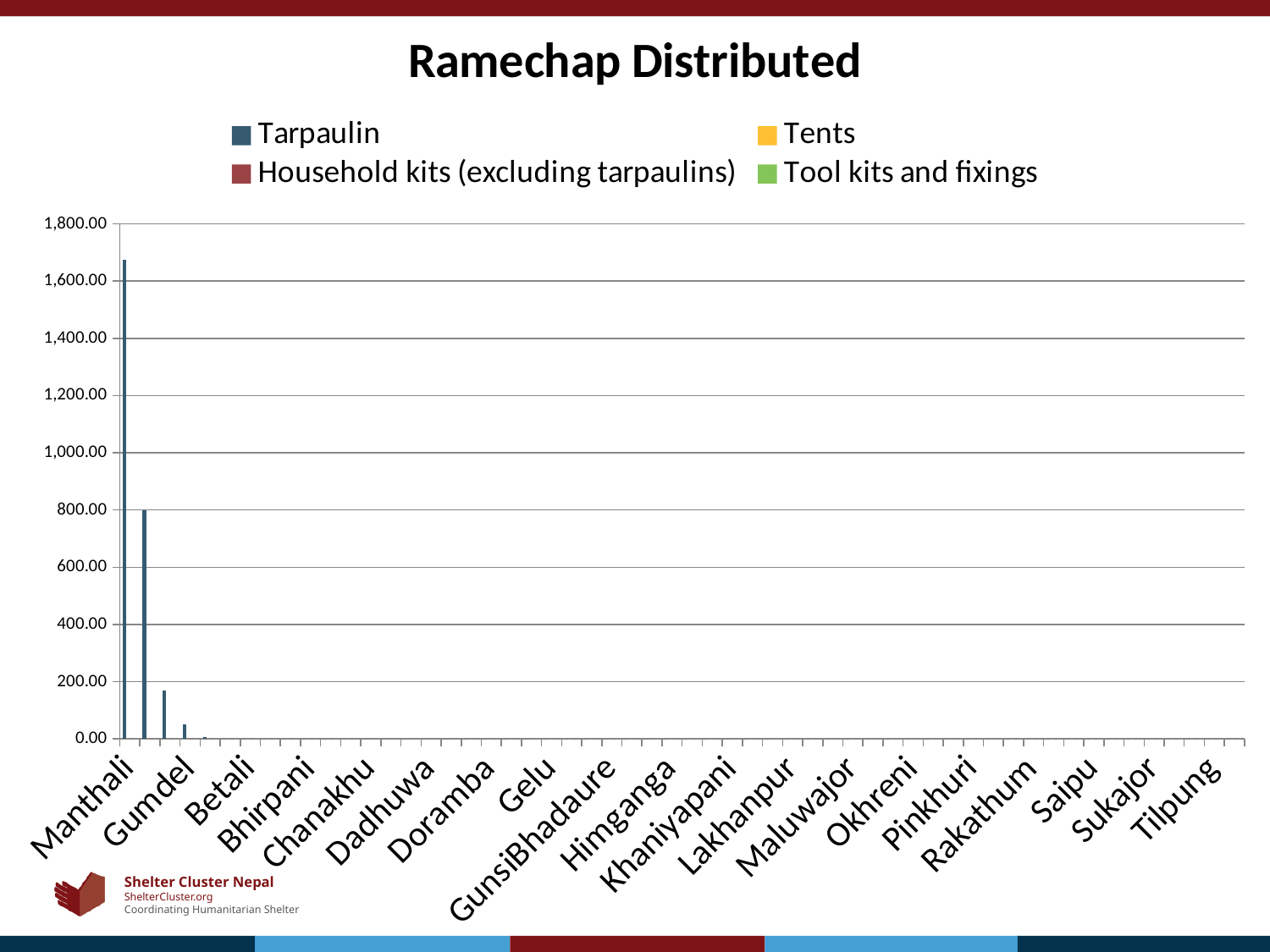
How many series does the legend list? 4 Which has the larger Tarpaulin value, Manthali or Gumdel? Manthali Is the Tarpaulin value for Manthali greater or less than 1,800? less What kind of chart is shown on the slide? Bar chart Which series is shown in blue in the legend? Tarpaulin What is the title of the chart? Ramechap Distributed Do the Tarpaulin values rise or fall moving from Manthali toward Tilpung along the x axis? fall Which category has the highest Tarpaulin value? Manthali Is the Tarpaulin value for Manthali greater or less than 1,600? greater What is the highest value shown on the vertical axis? 1,800.00